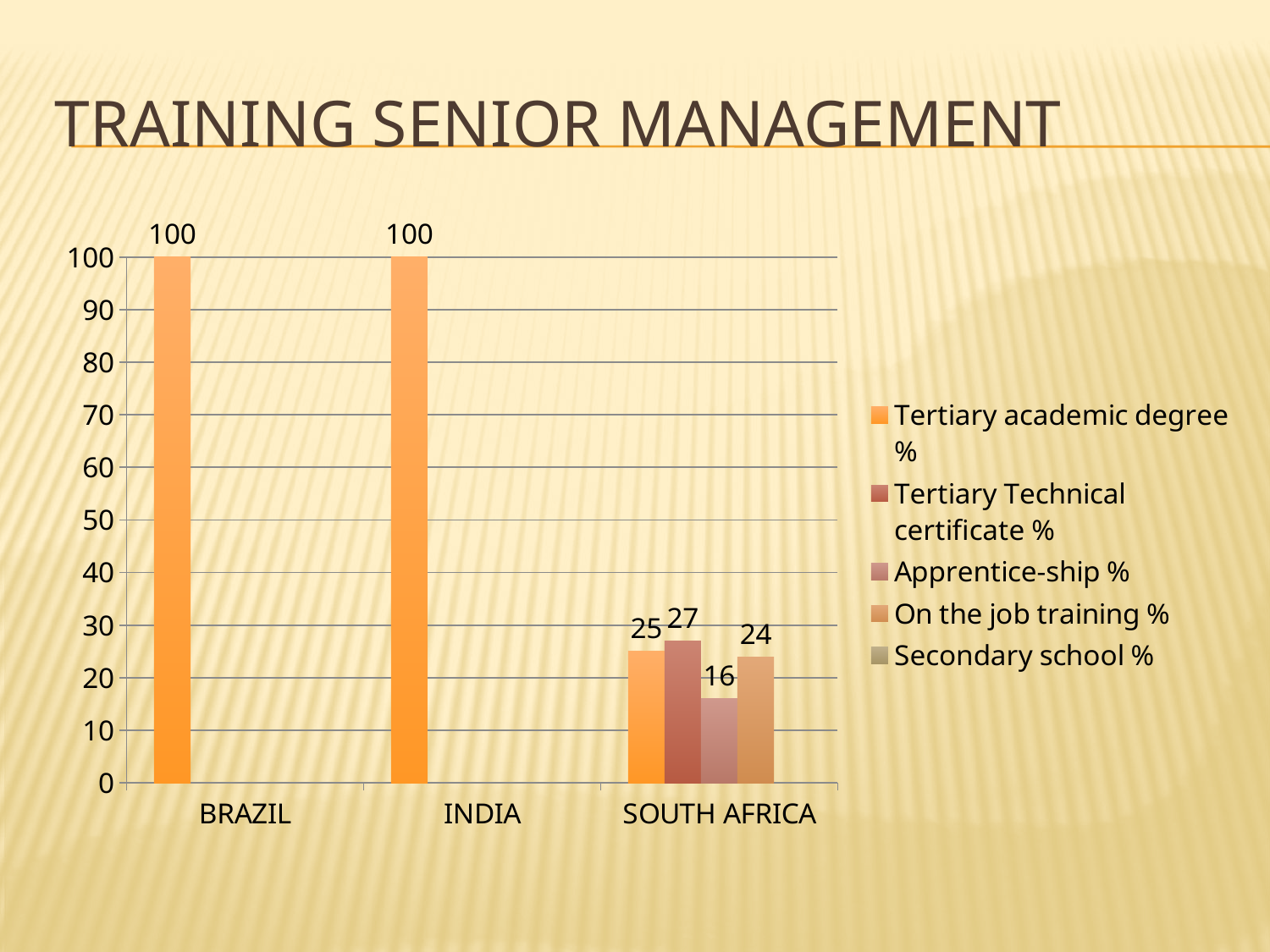
What is the Tertiary Technical certificate % value for South Africa? 27 What is the Tertiary academic degree % value for Brazil? 100 What is the Apprentice-ship % value for South Africa? 16 What is the Tertiary academic degree % value for India? 100 What is the On the job training % value for South Africa? 24 How many series does the legend list? 5 How many countries are shown on the x axis? 3 What kind of chart is shown on the slide? Bar chart Which series has the highest value for South Africa? Tertiary Technical certificate % For South Africa, which is larger: the Tertiary academic degree % value or the On the job training % value? Tertiary academic degree % Which series has the lowest value for South Africa? Apprentice-ship % What is the difference between the Tertiary Technical certificate % and the Apprentice-ship % values for South Africa? 11